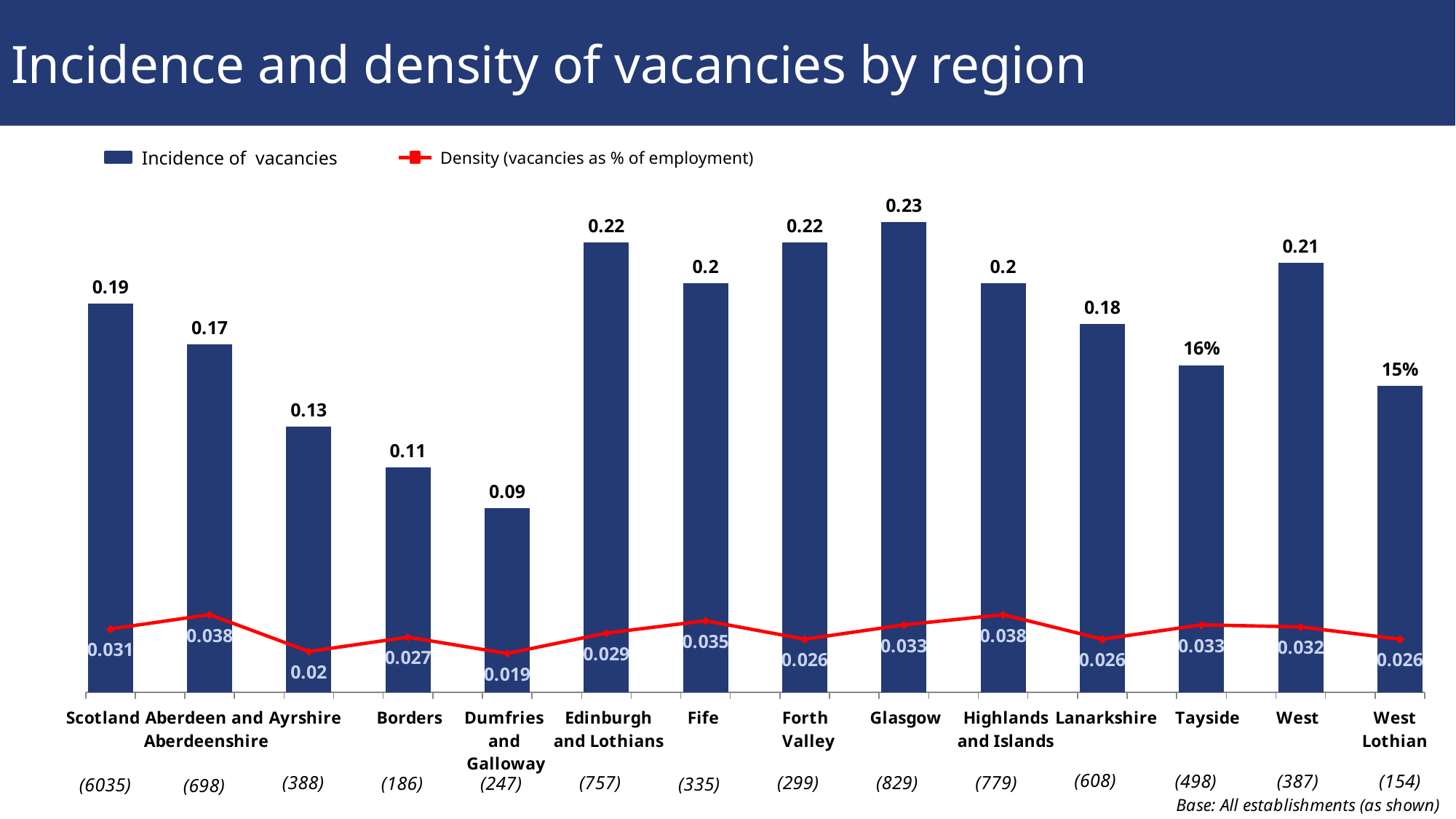
What kind of chart is shown on the slide? Combined bar and line chart What is the incidence of vacancies for Tayside? 16% Which region has the lowest incidence of vacancies? Dumfries and Galloway How many series does the legend list? 2 Which has a higher incidence of vacancies, Edinburgh and Lothians or Fife? Edinburgh and Lothians Which region has the highest incidence of vacancies? Glasgow How many regions are shown on the x axis? 14 What is the density value for Dumfries and Galloway? 0.019 What is the difference in incidence of vacancies between Glasgow and Dumfries and Galloway? 0.14 What is the density (vacancies as % of employment) for Fife? 0.035 Which region has the lowest density of vacancies? Dumfries and Galloway What is the incidence of vacancies for Glasgow? 0.23